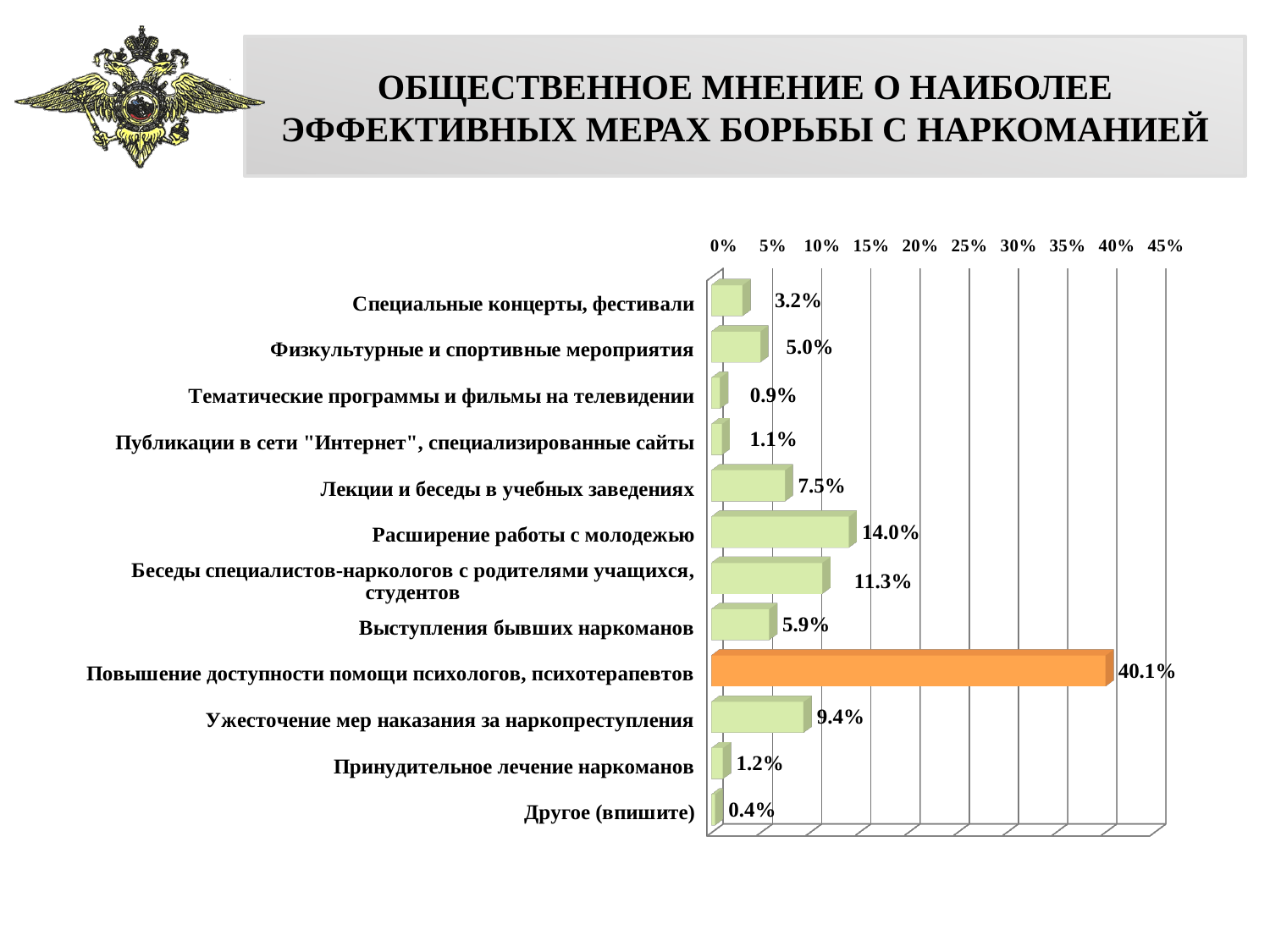
Which category has the lowest value? Другое (впишите) What is the difference between the values for "Расширение работы с молодежью" and "Беседы специалистов-наркологов с родителями учащихся, студентов"? 2.7% Which bar is coloured differently (orange) from the others? Повышение доступности помощи психологов, психотерапевтов How many categories are shown in the chart? 12 What is the value for "Лекции и беседы в учебных заведениях"? 7.5% What kind of chart is shown on the slide? bar chart Is the value for "Повышение доступности помощи психологов, психотерапевтов" greater or less than 35%? greater What is the value for "Физкультурные и спортивные мероприятия"? 5.0% Which category has the highest value? Повышение доступности помощи психологов, психотерапевтов What is the value for "Расширение работы с молодежью"? 14.0% What is the value for "Повышение доступности помощи психологов, психотерапевтов"? 40.1% Which is larger: the value for "Ужесточение мер наказания за наркопреступления" or for "Выступления бывших наркоманов"? Ужесточение мер наказания за наркопреступления